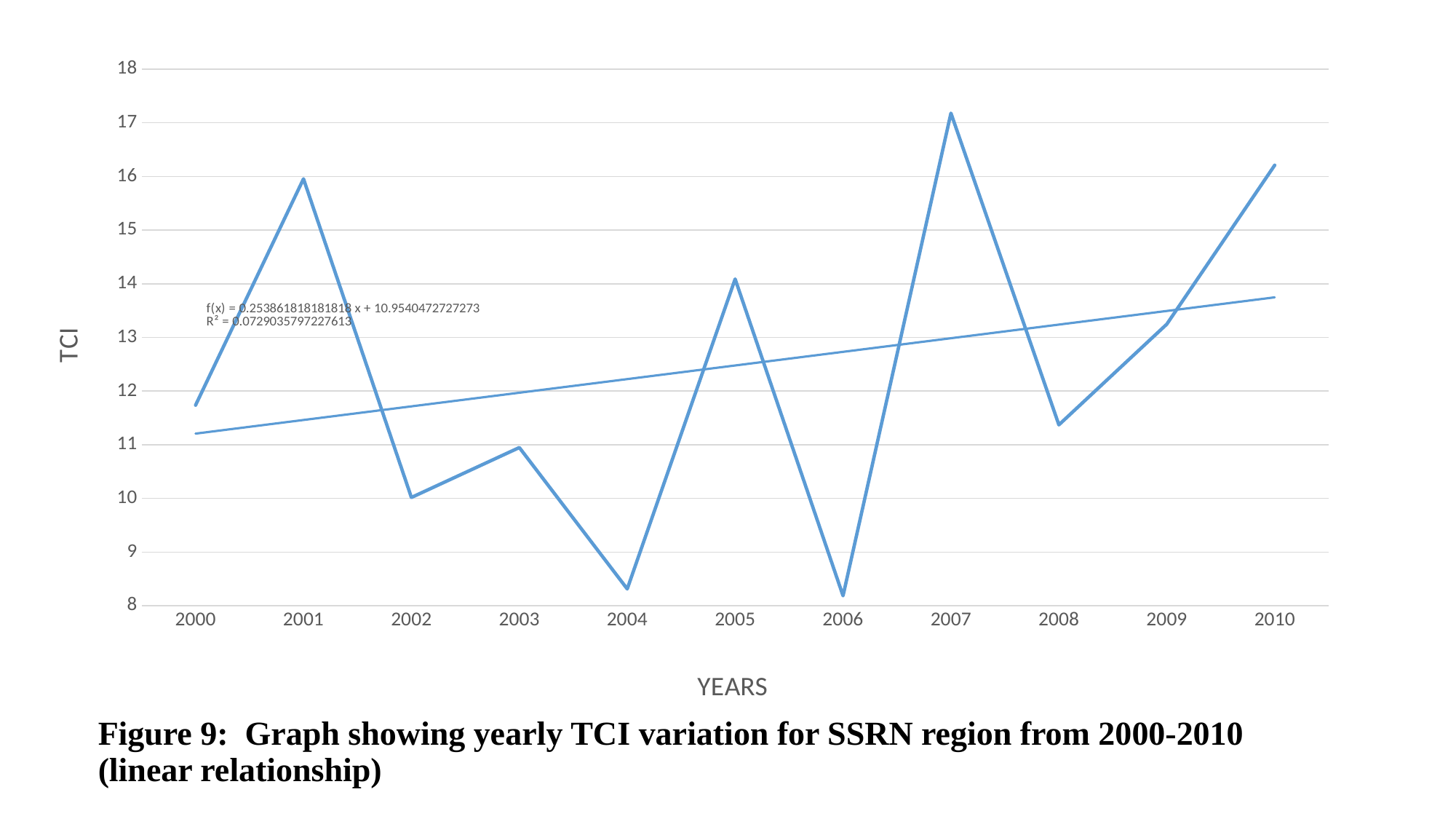
How many years are plotted along the x axis? 11 Is the TCI value for 2001 greater or less than 15? greater Is the TCI value for 2006 greater or less than 9? less What kind of chart is shown on the slide? line chart Does the linear trendline rise or fall from 2000 to 2010? rise Is the TCI value for 2008 greater or less than 12? less What is the label on the x axis of the chart? YEARS Which year has the larger TCI value, 2005 or 2006? 2005 Which year has the larger TCI value, 2001 or 2002? 2001 In which year is the TCI value highest? 2007